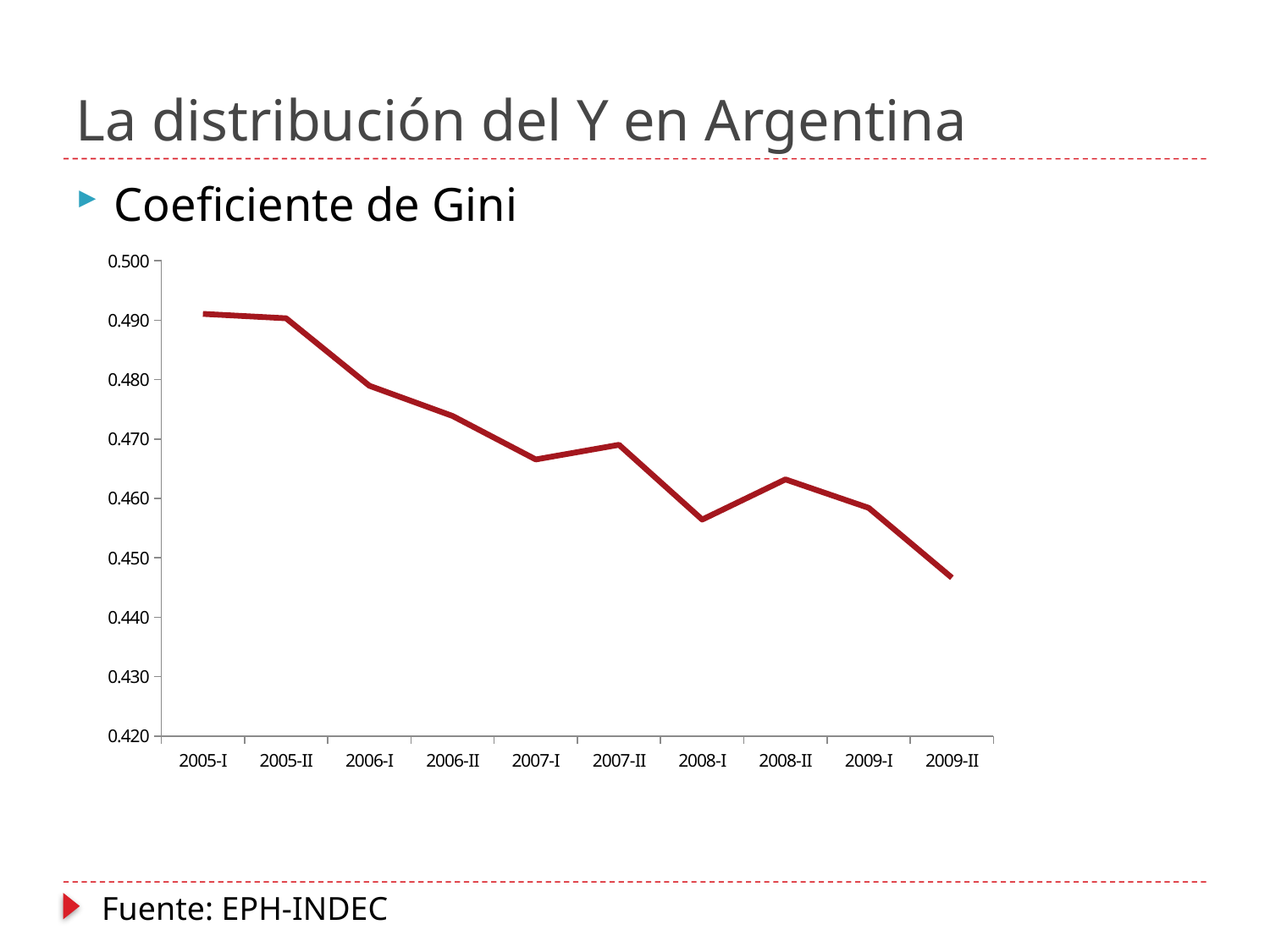
How many time periods are plotted along the x axis? 10 Overall, does the Gini coefficient rise or fall from 2005-I to 2009-II? fall Which is larger, the value for 2007-II or the value for 2008-I? 2007-II Is the value for 2006-II greater or less than 0.470? greater Is the value for 2006-I greater or less than 0.470? greater What source is cited for the chart data? EPH-INDEC Is the value for 2008-I greater or less than 0.460? less Which is larger, the value for 2008-II or the value for 2009-II? 2008-II What kind of chart is shown on the slide? line chart Which period has the lowest Gini coefficient? 2009-II What indicator does the chart show, according to the heading above it? Coeficiente de Gini